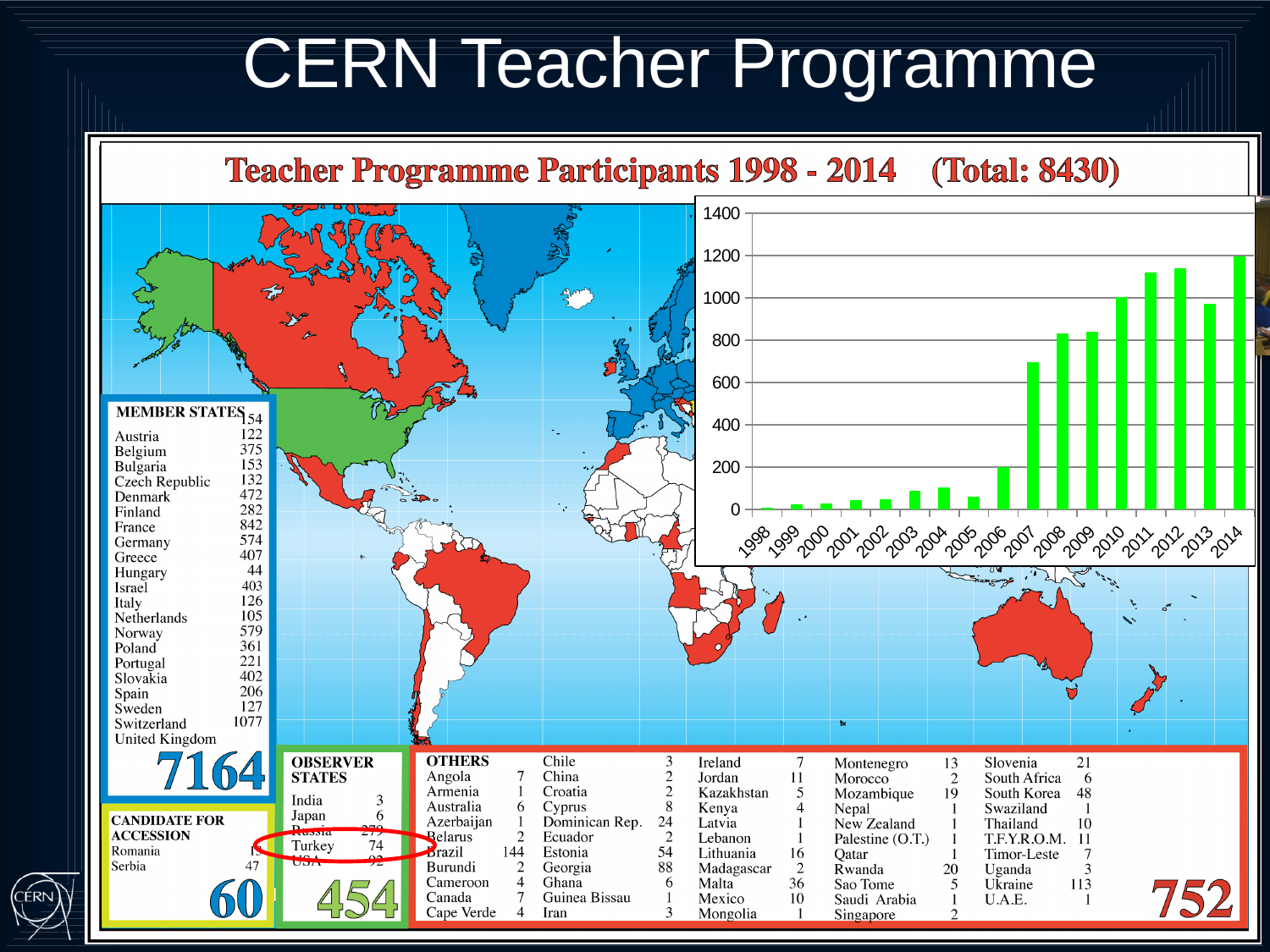
Is the value for 2013 greater or less than 800? greater Which year has more participants, 2006 or 2010? 2010 What kind of chart is shown on the slide? bar chart Is the value for 2007 greater or less than 800? less Is the value for 2011 greater or less than 1000? greater Do the participant numbers generally rise or fall from 1998 to 2014? rise What total number of participants is stated in the chart title? 8430 How many years are plotted on the x axis of the bar chart? 17 Which year has the highest number of participants in the bar chart? 2014 Which year has the lowest number of participants in the bar chart? 1998